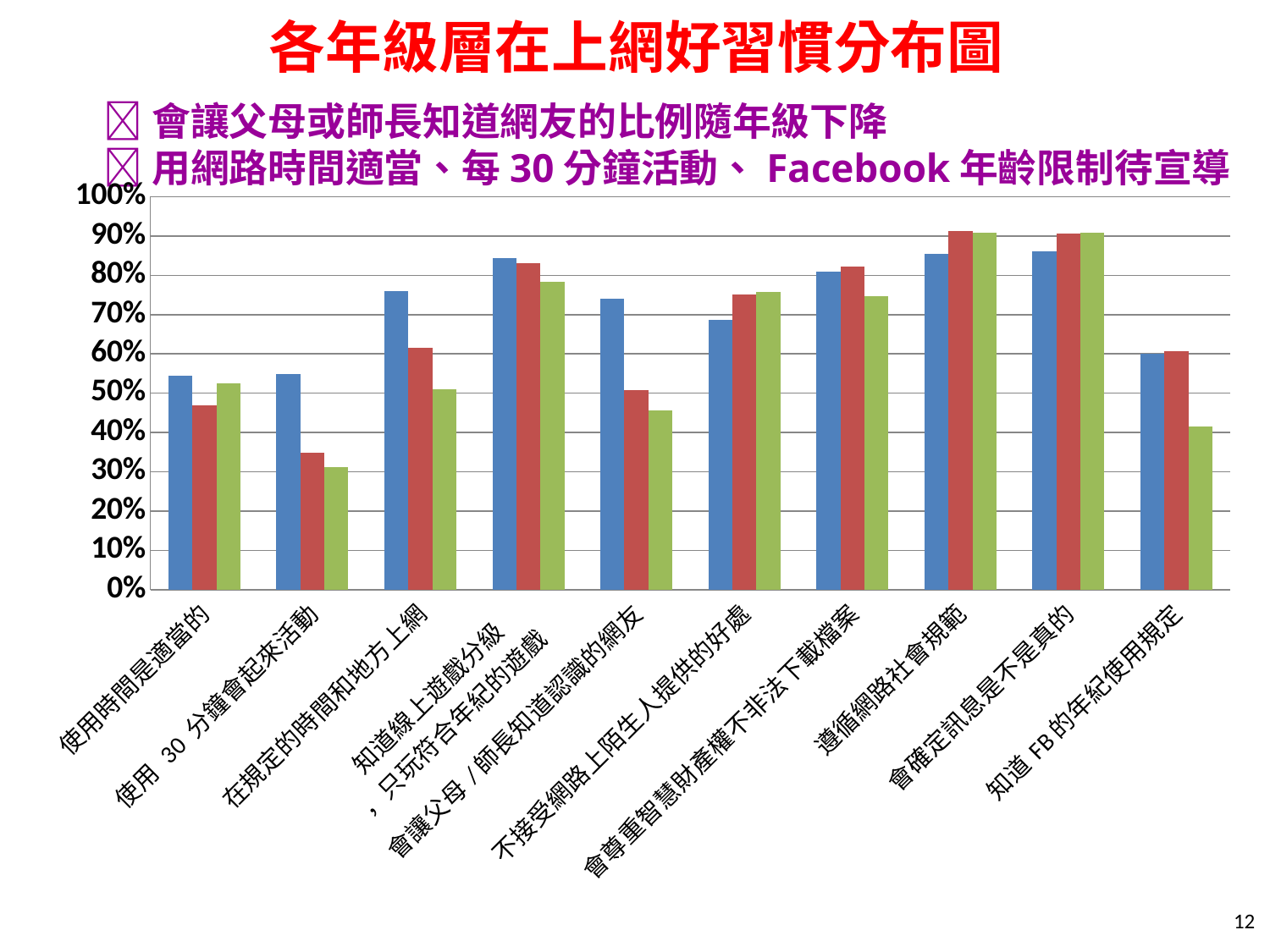
How many categories are shown along the x axis of the chart? 10 How many bars are plotted for each category in the chart? 3 For 會讓父母/師長知道認識的網友, do the three bars rise or fall from left to right? fall Is the value of the green bar for 知道 FB 的年紀使用規定 greater or less than 50%? less Is the value of the green bar for 使用 30 分鐘會起來活動 greater or less than 40%? less What is the title of the slide above the chart? 各年級層在上網好習慣分布圖 Is the value of the green bar for 會讓父母/師長知道認識的網友 greater or less than 50%? less Among the green bars, which category has the lowest value? 使用 30 分鐘會起來活動 For 知道 FB 的年紀使用規定, which bar is larger, the red bar or the green bar? red bar What kind of chart is shown on the slide? bar chart